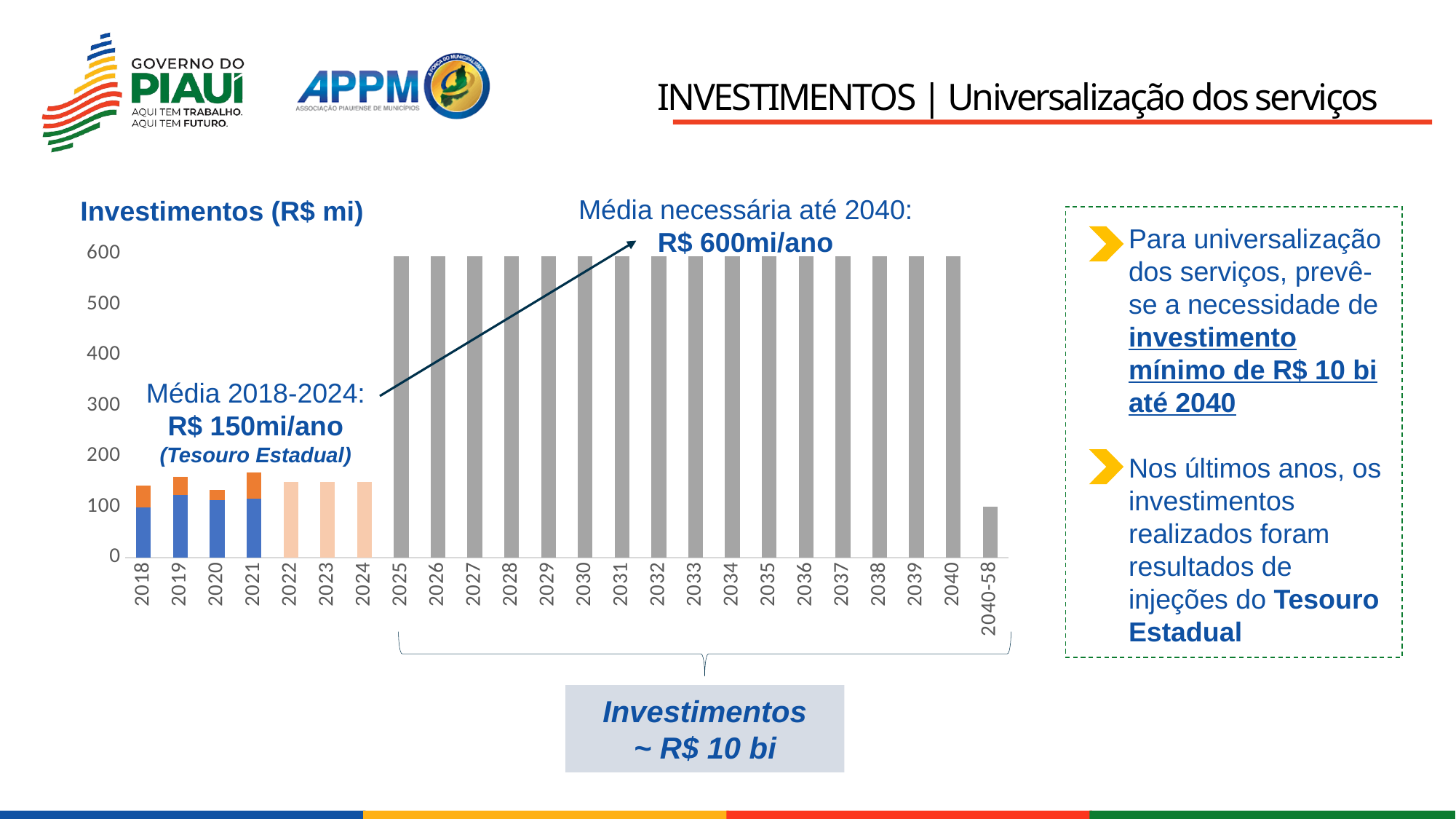
How many categories (bars) are shown along the x axis of the chart? 24 What is the highest value shown on the y axis of the chart? 600 Is the value for 2018 greater or less than 200? less What is the title of the chart? Investimentos (R$ mi) Which has the larger value, 2040-58 or 2028? 2028 Is the value for 2030 greater or less than 500? greater Is the value for 2040-58 greater or less than 200? less Which has the larger value, 2035 or 2019? 2035 According to the annotation on the chart, what is the average annual investment needed until 2040? R$ 600mi/ano Do the bar values rise or fall from 2021 to 2025? rise What kind of chart is shown on the slide? bar chart